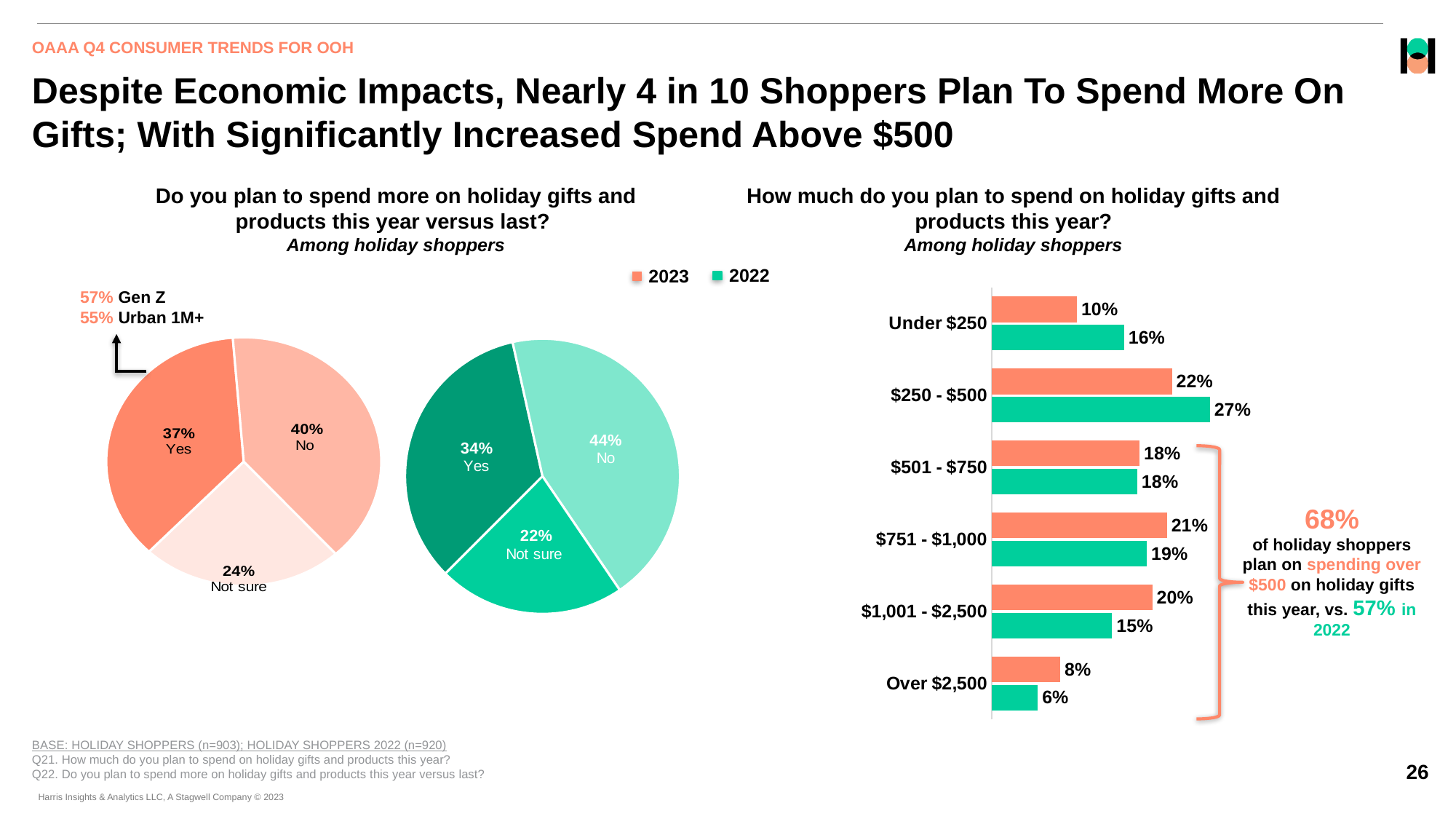
In the 2022 pie chart for 'Do you plan to spend more on holiday gifts and products this year versus last?', which response has the largest slice? No In the bar chart 'How much do you plan to spend on holiday gifts and products this year?', which spending range has the highest 2023 value? $250 - $500 In the bar chart 'How much do you plan to spend on holiday gifts and products this year?', which spending range has the lowest 2022 value? Over $2,500 Comparing the two pie charts, how many percentage points higher is the Yes share in 2023 than in 2022? 3 percentage points In the 2023 pie chart for 'Do you plan to spend more on holiday gifts and products this year versus last?', what share of holiday shoppers answered Yes? 37% In the bar chart 'How much do you plan to spend on holiday gifts and products this year?', what is the 2023 value for $250 - $500? 22% In the bar chart 'How much do you plan to spend on holiday gifts and products this year?', how many spending ranges are shown? 6 In the bar chart 'How much do you plan to spend on holiday gifts and products this year?', what is the 2022 value for $1,001 - $2,500? 15% In the 2023 pie chart for 'Do you plan to spend more on holiday gifts and products this year versus last?', which response has the smallest slice? Not sure In the bar chart 'How much do you plan to spend on holiday gifts and products this year?', what is the difference between the 2022 and 2023 values for Under $250? 6 percentage points In the 2022 pie chart for 'Do you plan to spend more on holiday gifts and products this year versus last?', what share of holiday shoppers answered No? 44% In the bar chart 'How much do you plan to spend on holiday gifts and products this year?', how many series does the legend list? 2